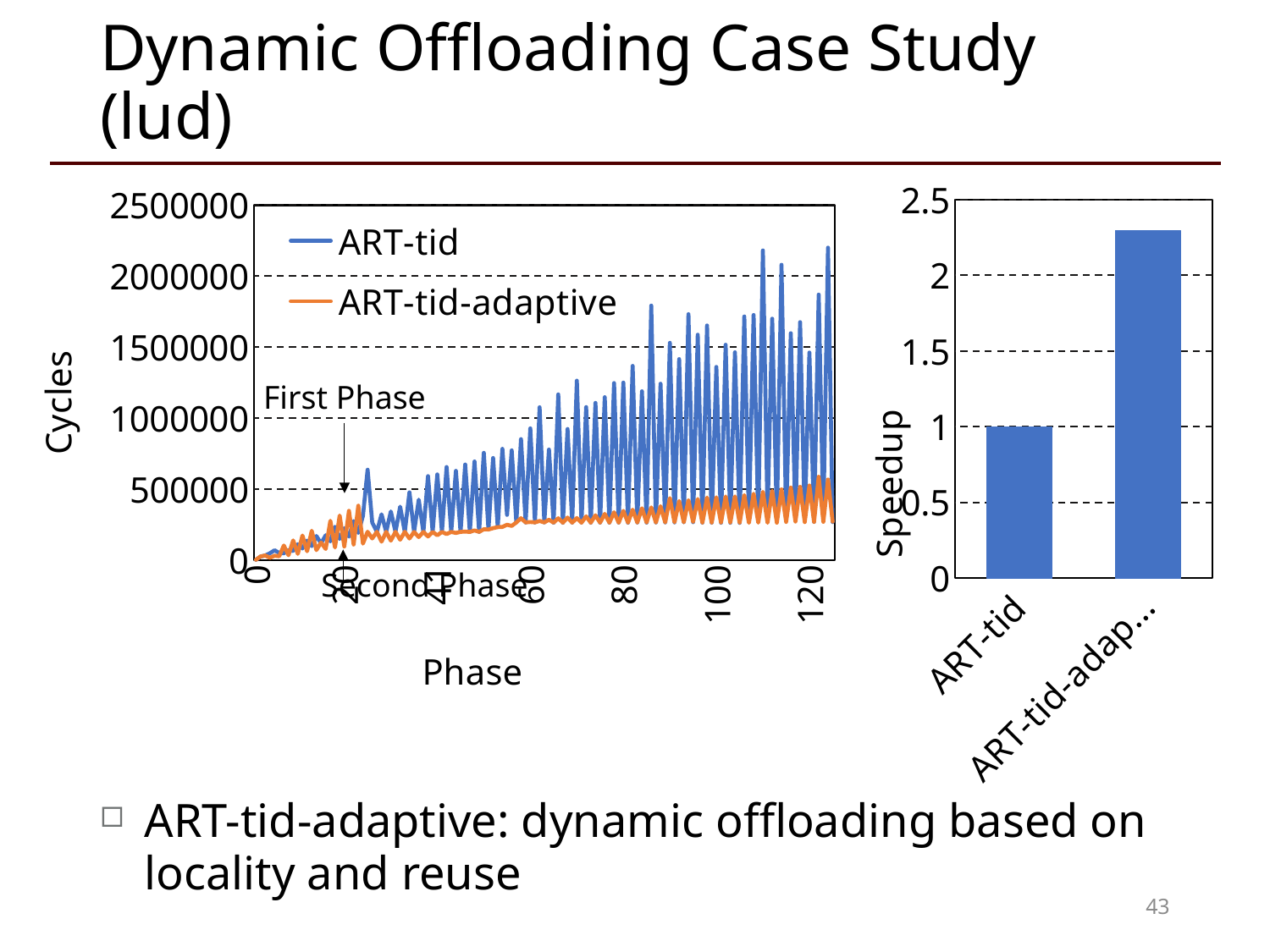
In the right bar chart, is the speedup for the right-hand bar (ART-tid-adaptive) greater or less than 2? greater What kind of chart is the right chart on the slide? bar chart What is the label of the y axis of the left line chart? Cycles In the left line chart, which series has the higher cycle values in the later phases, ART-tid or ART-tid-adaptive? ART-tid How many bars are plotted in the right bar chart? 2 In the right bar chart, which category has the lowest speedup? ART-tid In the left line chart, do the ART-tid cycle values generally rise or fall as the phase increases? rise In the right bar chart, which category has the higher speedup? ART-tid-adaptive How many series does the legend of the left chart list? 2 In the left line chart, is the highest peak of the ART-tid series greater or less than 2000000 cycles? greater What kind of chart is the left chart on the slide? line chart In the right bar chart, what is the speedup value for ART-tid? 1